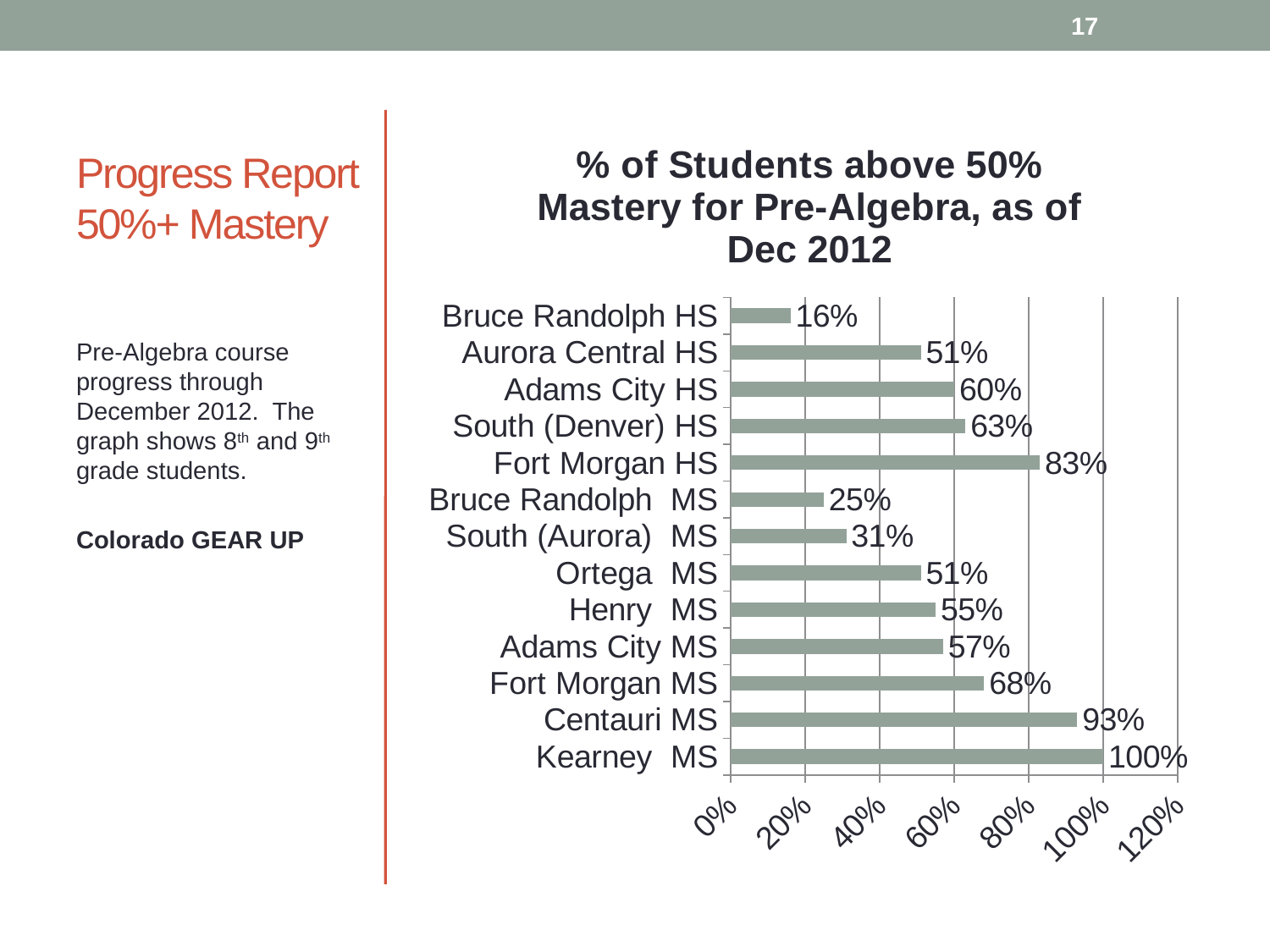
Which school has the lowest value? Bruce Randolph HS What kind of chart is shown on the slide? bar chart What is the value for Bruce Randolph MS? 25% Which is larger, the value for South (Denver) HS or the value for Henry MS? South (Denver) HS Is the value for South (Aurora) MS greater or less than 40%? less How many schools are shown in the chart? 13 What is the difference between Kearney MS and Bruce Randolph HS? 84% What is the value for Fort Morgan HS? 83% What is the title of the chart? % of Students above 50% Mastery for Pre-Algebra, as of Dec 2012 Which school has the highest value? Kearney MS What is the value for Centauri MS? 93% What is the difference between Fort Morgan MS and Adams City MS? 11%